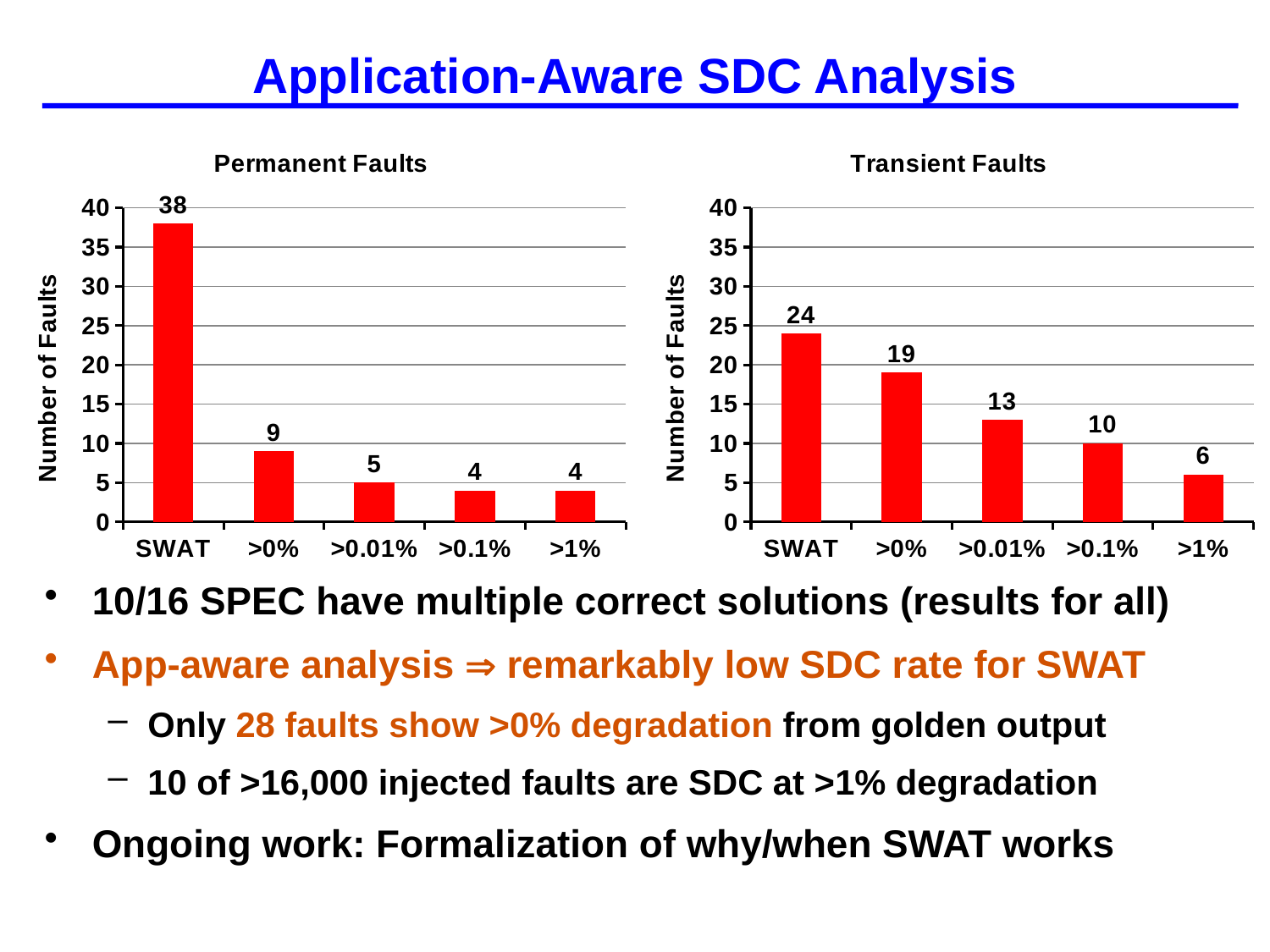
In the Transient Faults chart, do the values rise or fall from left to right along the x axis? Fall In the Transient Faults chart, what is the number of faults for >0.01%? 13 In the Transient Faults chart, what is the difference between the >0% value and the >0.1% value? 9 In the Permanent Faults chart, how many categories are shown on the x axis? 5 In the Permanent Faults chart, what is the difference between the SWAT value and the >0% value? 29 In the Transient Faults chart, which category has the highest number of faults? SWAT In the Permanent Faults chart, what is the value for >0.1%? 4 In the Permanent Faults chart, what is the y-axis label? Number of Faults Which is larger: the SWAT value in the Permanent Faults chart or the SWAT value in the Transient Faults chart? Permanent Faults In the Permanent Faults chart, what is the number of faults for SWAT? 38 What kind of chart is the Transient Faults chart? Bar chart In the Transient Faults chart, which category has the lowest number of faults? >1%